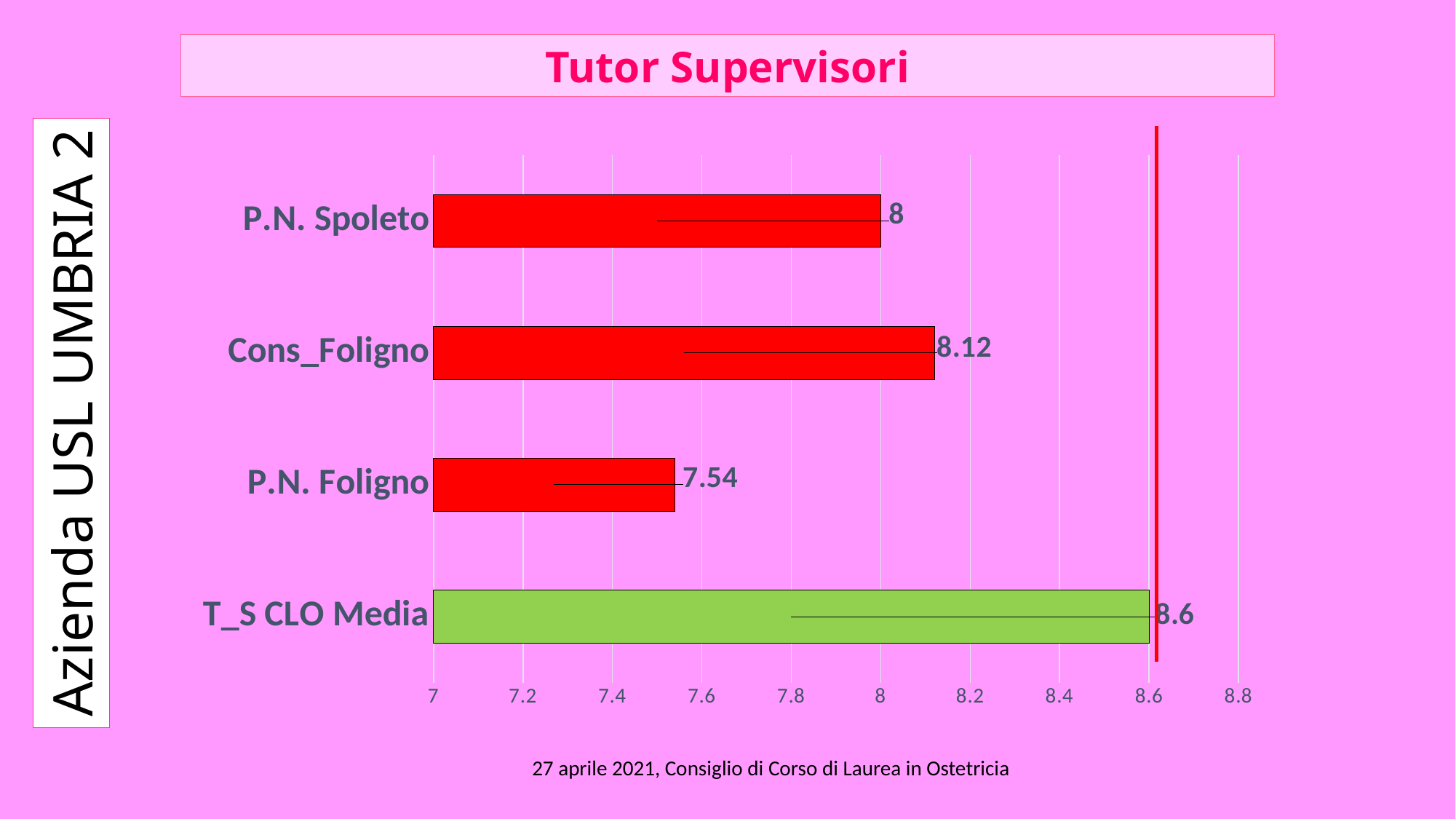
Which category has the lowest value? P.N. Foligno What kind of chart is shown on the slide? bar chart What is the value for Cons_Foligno? 8.12 How many categories are shown in the chart? 4 What is the difference between the values for Cons_Foligno and P.N. Foligno? 0.58 What is the value for P.N. Foligno? 7.54 What is the value for T_S CLO Media? 8.6 What is the difference between the values for T_S CLO Media and P.N. Spoleto? 0.6 What is the value for P.N. Spoleto? 8 What is the title of the chart? Tutor Supervisori Which category has the highest value? T_S CLO Media Which is larger, the value for Cons_Foligno or the value for P.N. Spoleto? Cons_Foligno